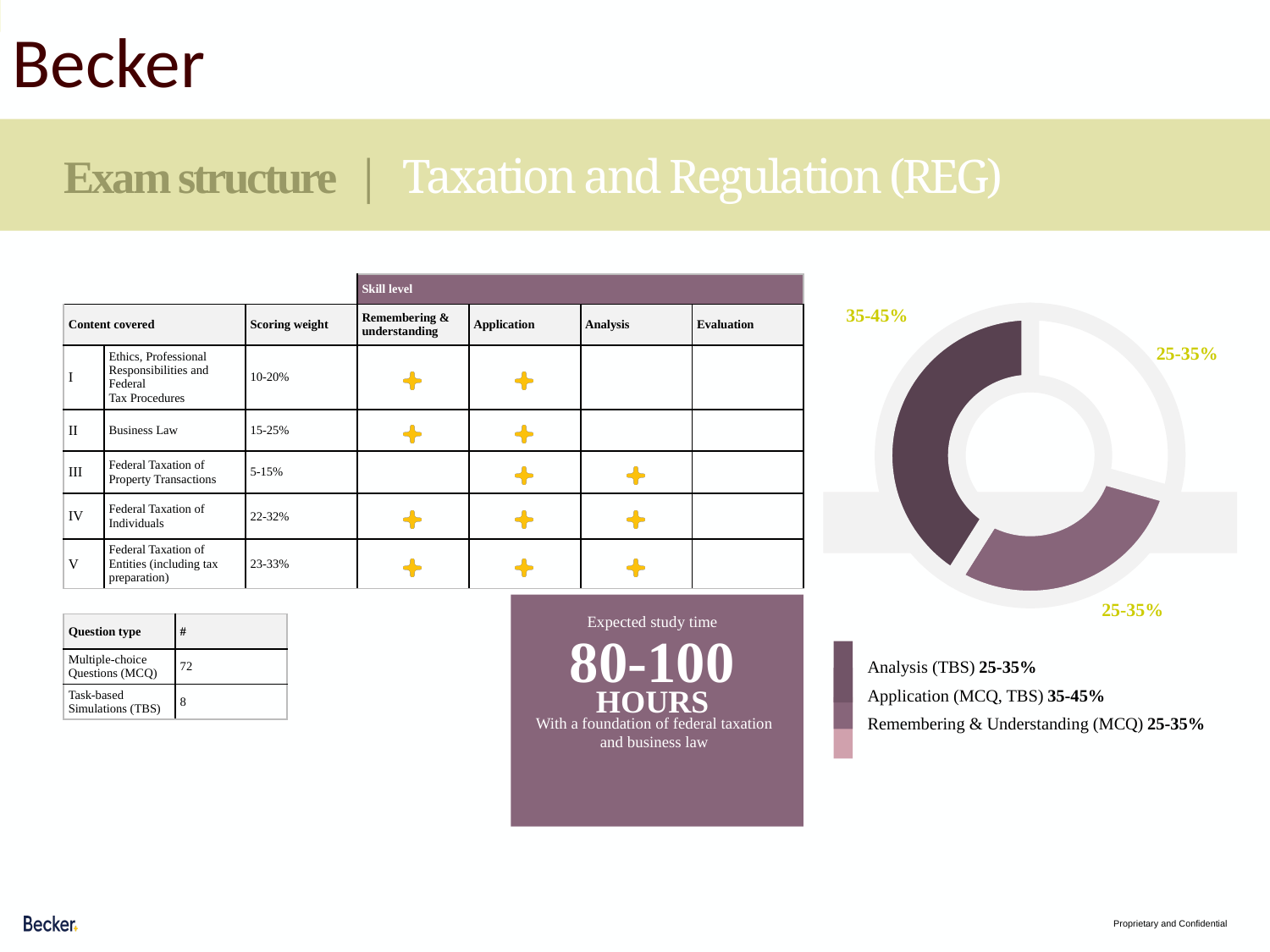
Which two skill levels in the doughnut chart share the same scoring weight of 25-35%? Analysis (TBS) and Remembering & Understanding (MCQ) How many slices does the doughnut chart have? 3 What scoring weight is shown for Application (MCQ, TBS) in the doughnut chart? 35-45% In the doughnut chart, which is larger: Application (MCQ, TBS) or Analysis (TBS)? Application (MCQ, TBS) How many entries does the legend of the doughnut chart list? 3 What is the largest percentage label shown on the doughnut chart? 35-45% What scoring weight is shown for Analysis (TBS) in the doughnut chart? 25-35% Which skill level has the largest slice in the doughnut chart? Application (MCQ, TBS) What scoring weight is shown for Remembering & Understanding (MCQ) in the doughnut chart? 25-35% What kind of chart is shown on the right side of the slide? Doughnut chart